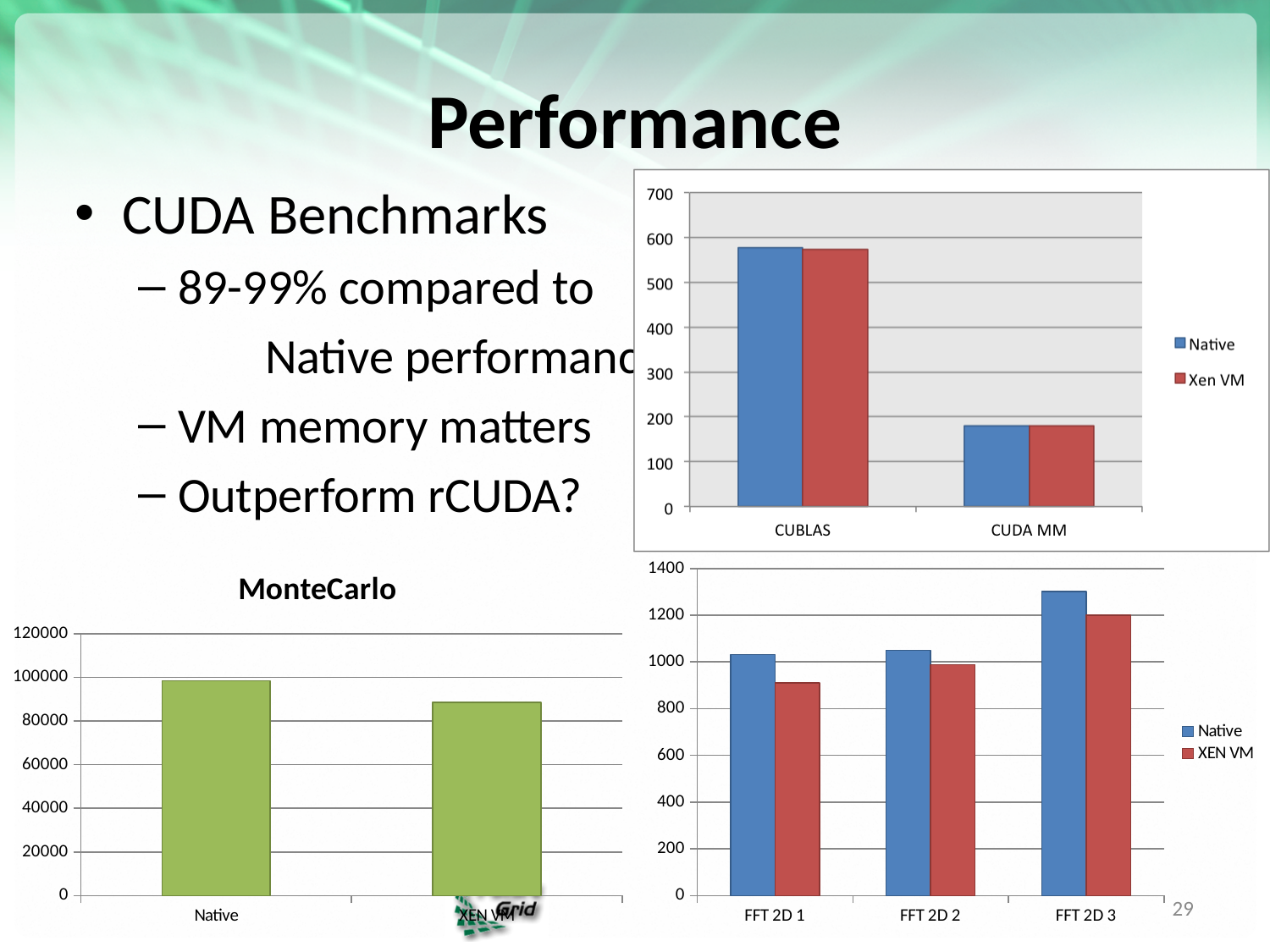
In the top-right chart (CUBLAS and CUDA MM), is the Xen VM value for CUDA MM greater or less than 300? less How many categories are shown in the MonteCarlo chart? 2 In the bottom-right chart (FFT 2D), is the XEN VM value for FFT 2D 1 greater or less than 1000? less What kind of chart is the MonteCarlo chart? bar chart In the top-right chart (CUBLAS and CUDA MM), which category has the higher Native value? CUBLAS In the MonteCarlo chart, which category has the higher value, Native or XEN VM? Native In the MonteCarlo chart, is the value for XEN VM greater or less than 80000? greater In the bottom-right chart (FFT 2D), which category has the highest Native value? FFT 2D 3 In the bottom-right chart (FFT 2D), how many categories are shown on the x axis? 3 How many series does the legend of the top-right chart (CUBLAS and CUDA MM) list? 2